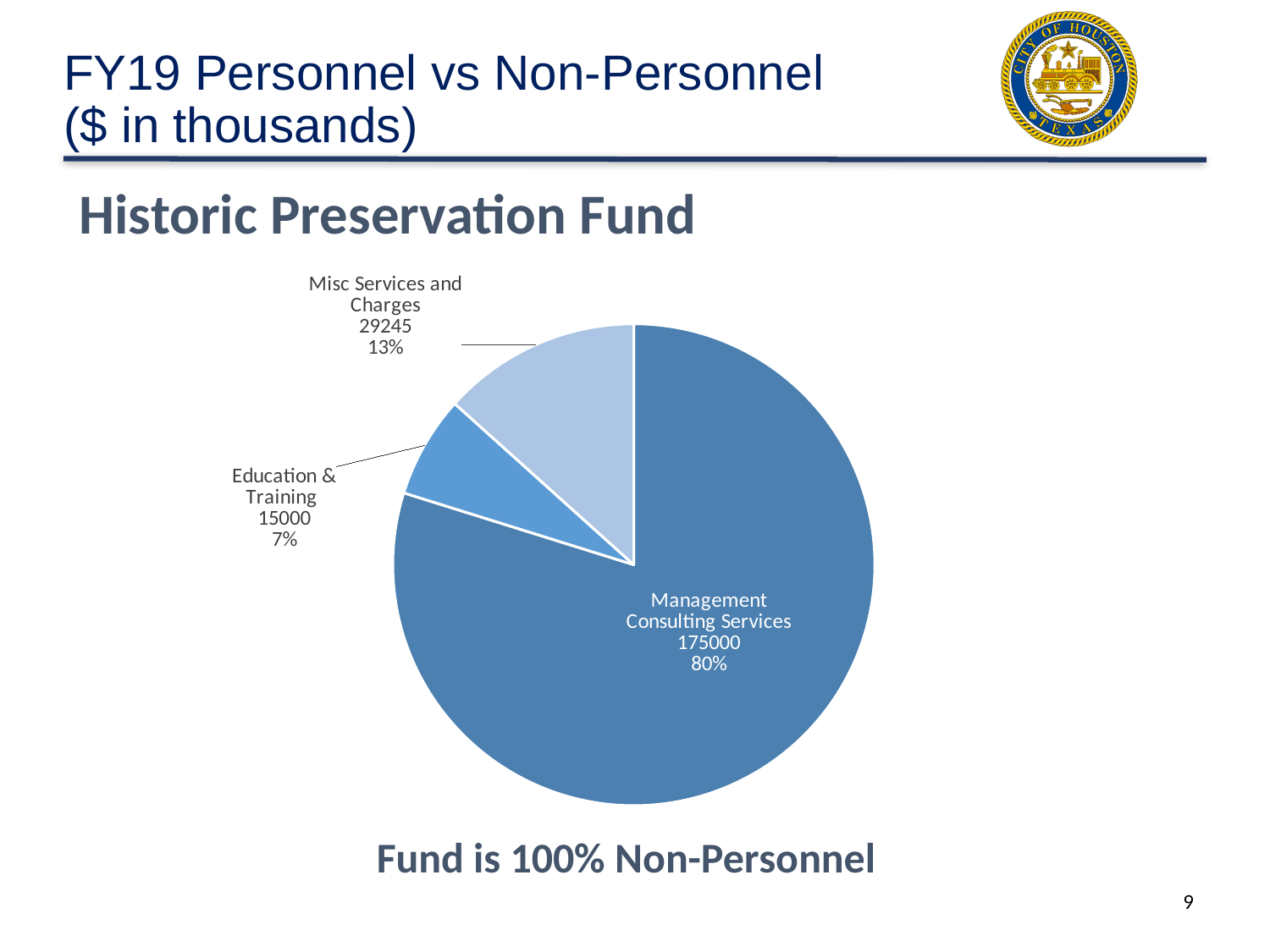
What share of the pie does Misc Services and Charges represent? 13% What is the value for Misc Services and Charges? 29245 Which category has the largest slice? Management Consulting Services How many categories are shown in the pie chart? 3 Which is larger, Misc Services and Charges or Education & Training? Misc Services and Charges What is the difference between the values for Misc Services and Charges and Education & Training? 14245 What share of the pie does Education & Training represent? 7% What share of the pie does Management Consulting Services represent? 80% Which category has the smallest slice? Education & Training What is the value for Education & Training? 15000 What is the value for Management Consulting Services? 175000 What type of chart is shown on the slide? pie chart